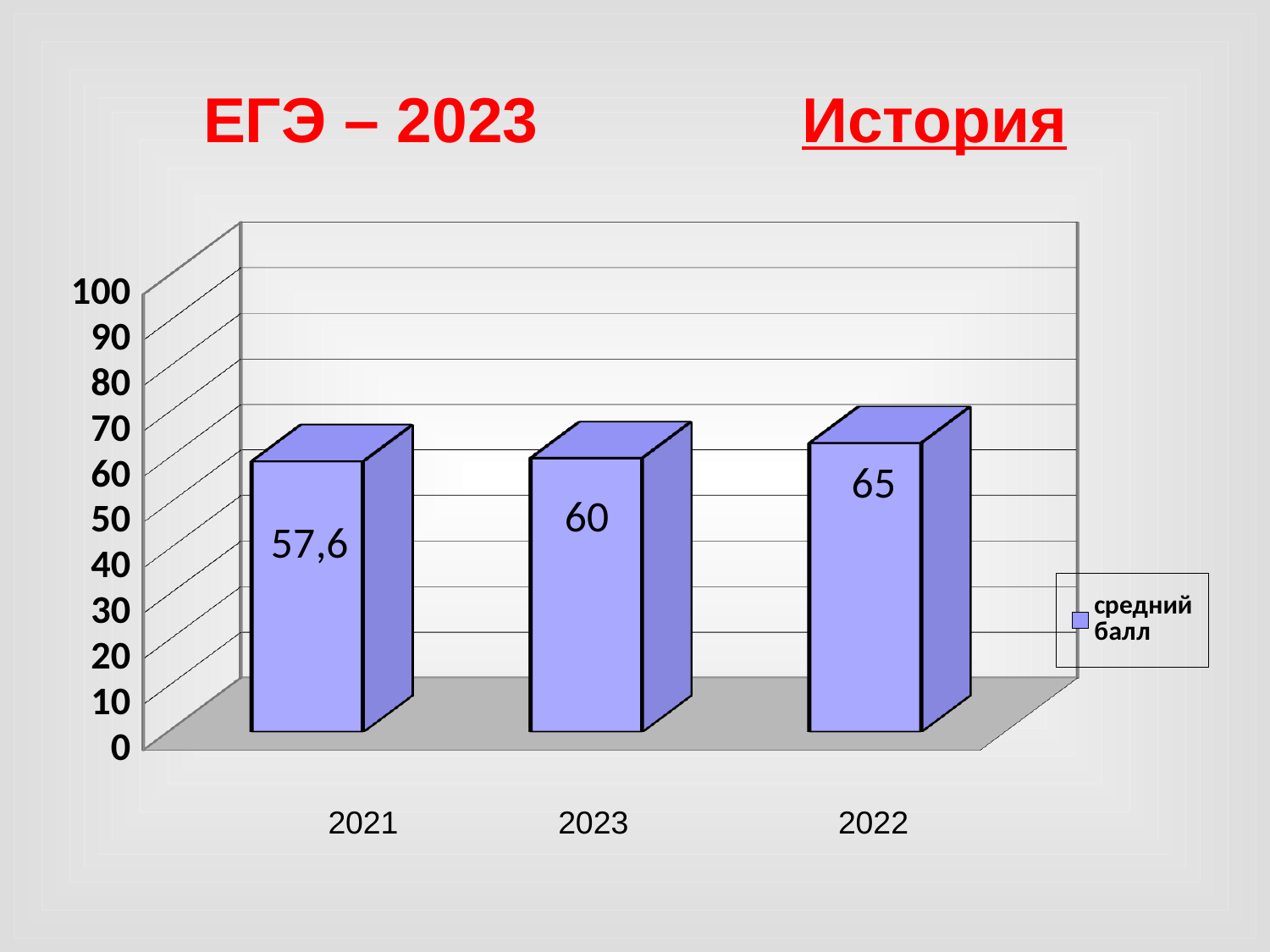
What is the average score (средний балл) shown for 2021? 57,6 What is the average score shown for 2022? 65 Which year has the lowest average score on the chart? 2021 What is the average score shown for 2023? 60 What is the legend entry for the series shown on the chart? средний балл How many years (categories) are shown on the chart? 3 Which is larger, the average score for 2023 or for 2021? 2023 What is the difference between the average scores for 2022 and 2021? 7,4 Which year has the highest average score on the chart? 2022 What kind of chart is shown on the slide? bar chart Is the value for 2022 greater or less than 70? less What is the difference between the average scores for 2022 and 2023? 5